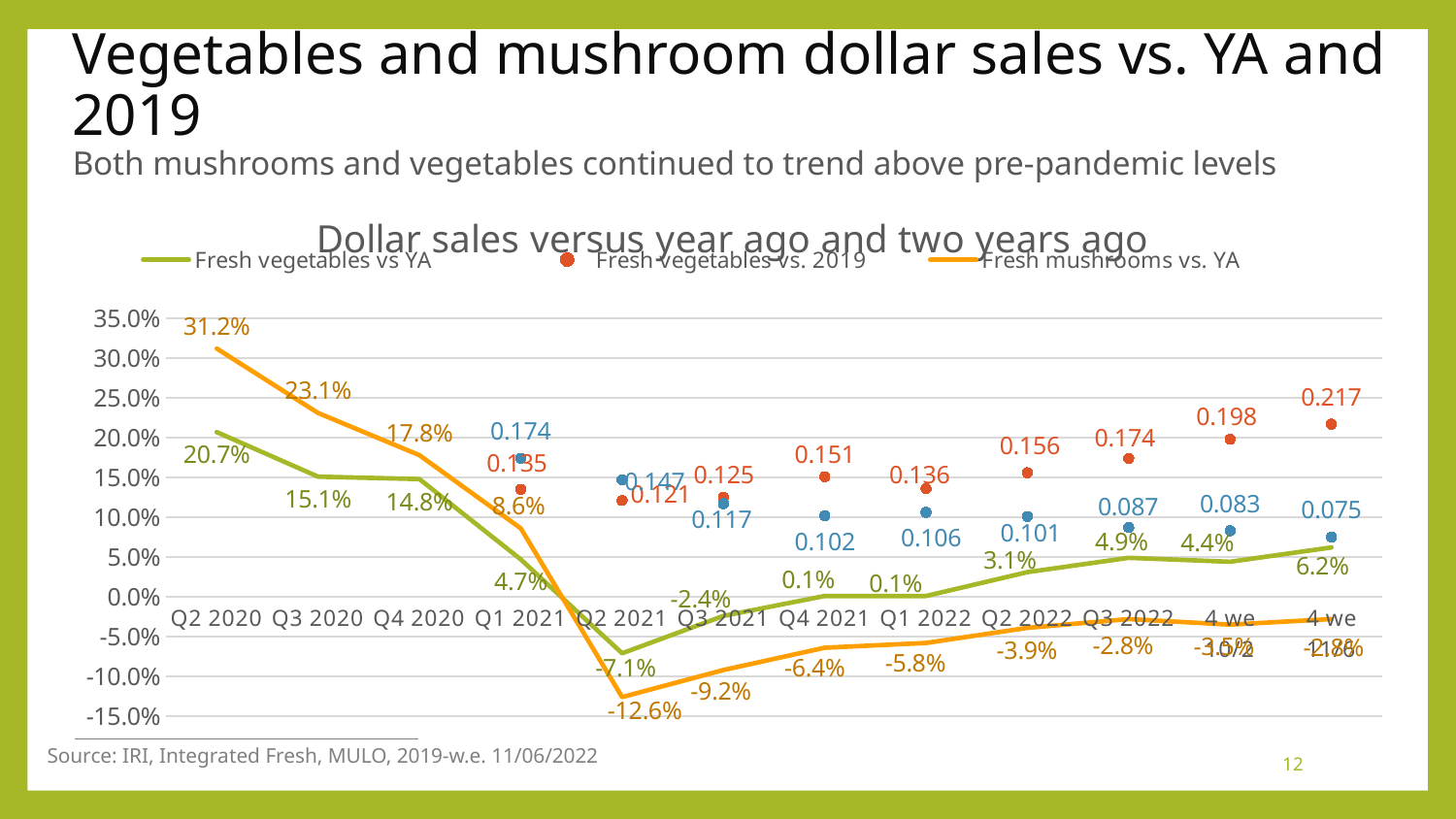
What is the value for Fresh vegetables vs. 2019 in Q4 2021? 0.151 What is the value for Fresh mushrooms vs. YA in Q2 2020? 31.2% What kind of chart is this? Line chart What is the value for Fresh vegetables vs YA in Q3 2022? 4.9% Does Fresh mushrooms vs. YA rise or fall from Q2 2020 to Q2 2021? Fall In which period is Fresh mushrooms vs. YA at its lowest? Q2 2021 In Q2 2020, how much higher is Fresh mushrooms vs. YA than Fresh vegetables vs YA? 10.5 percentage points In Q3 2020, which is larger: Fresh mushrooms vs. YA or Fresh vegetables vs YA? Fresh mushrooms vs. YA In which period is Fresh vegetables vs YA at its highest? Q2 2020 How many periods are shown on the x axis? 12 How many series does the legend list? 3 What is the value for Fresh vegetables vs YA in Q2 2021? -7.1%